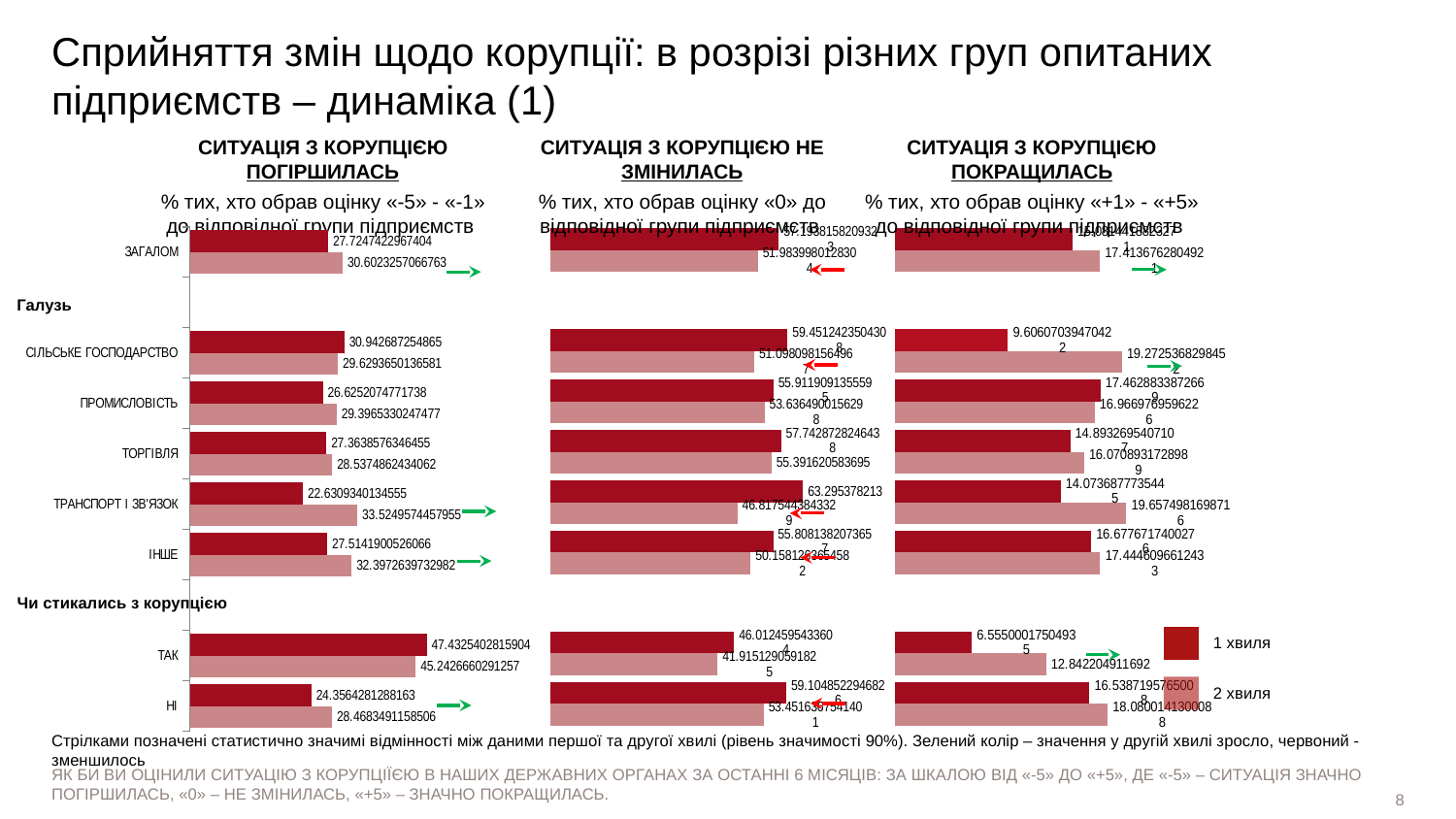
In the chart titled «СИТУАЦІЯ З КОРУПЦІЄЮ ПОГІРШИЛАСЬ», for СІЛЬСЬКЕ ГОСПОДАРСТВО, which series has the larger value, 1 хвиля or 2 хвиля? 1 хвиля In the chart titled «СИТУАЦІЯ З КОРУПЦІЄЮ ПОГІРШИЛАСЬ», what is the value for ТАК in the 1 хвиля series? 47.4325402815904 In the chart titled «СИТУАЦІЯ З КОРУПЦІЄЮ ПОКРАЩИЛАСЬ», which category has the lowest 1 хвиля value? ТАК In the chart titled «СИТУАЦІЯ З КОРУПЦІЄЮ ПОГІРШИЛАСЬ», what is the value for ТРАНСПОРТ І ЗВ'ЯЗОК in the 2 хвиля series? 33.5249574457955 In the chart titled «СИТУАЦІЯ З КОРУПЦІЄЮ НЕ ЗМІНИЛАСЬ», what is the value for ПРОМИСЛОВІСТЬ in the 1 хвиля series? 55.911909135559 In the chart titled «СИТУАЦІЯ З КОРУПЦІЄЮ ПОГІРШИЛАСЬ», which category has the highest 1 хвиля value? ТАК In the chart titled «СИТУАЦІЯ З КОРУПЦІЄЮ НЕ ЗМІНИЛАСЬ», for ТАК, which series has the larger value, 1 хвиля or 2 хвиля? 1 хвиля How many series does the legend on the slide list? 2 What are the two legend entries shown on the slide? 1 хвиля and 2 хвиля What kind of chart is the chart titled «СИТУАЦІЯ З КОРУПЦІЄЮ ПОГІРШИЛАСЬ»? Bar chart In the chart titled «СИТУАЦІЯ З КОРУПЦІЄЮ ПОКРАЩИЛАСЬ», what is the value for ТАК in the 2 хвиля series? 12.842204911692 In the chart titled «СИТУАЦІЯ З КОРУПЦІЄЮ ПОКРАЩИЛАСЬ», what is the value for СІЛЬСЬКЕ ГОСПОДАРСТВО in the 1 хвиля series? 9.60607039470422